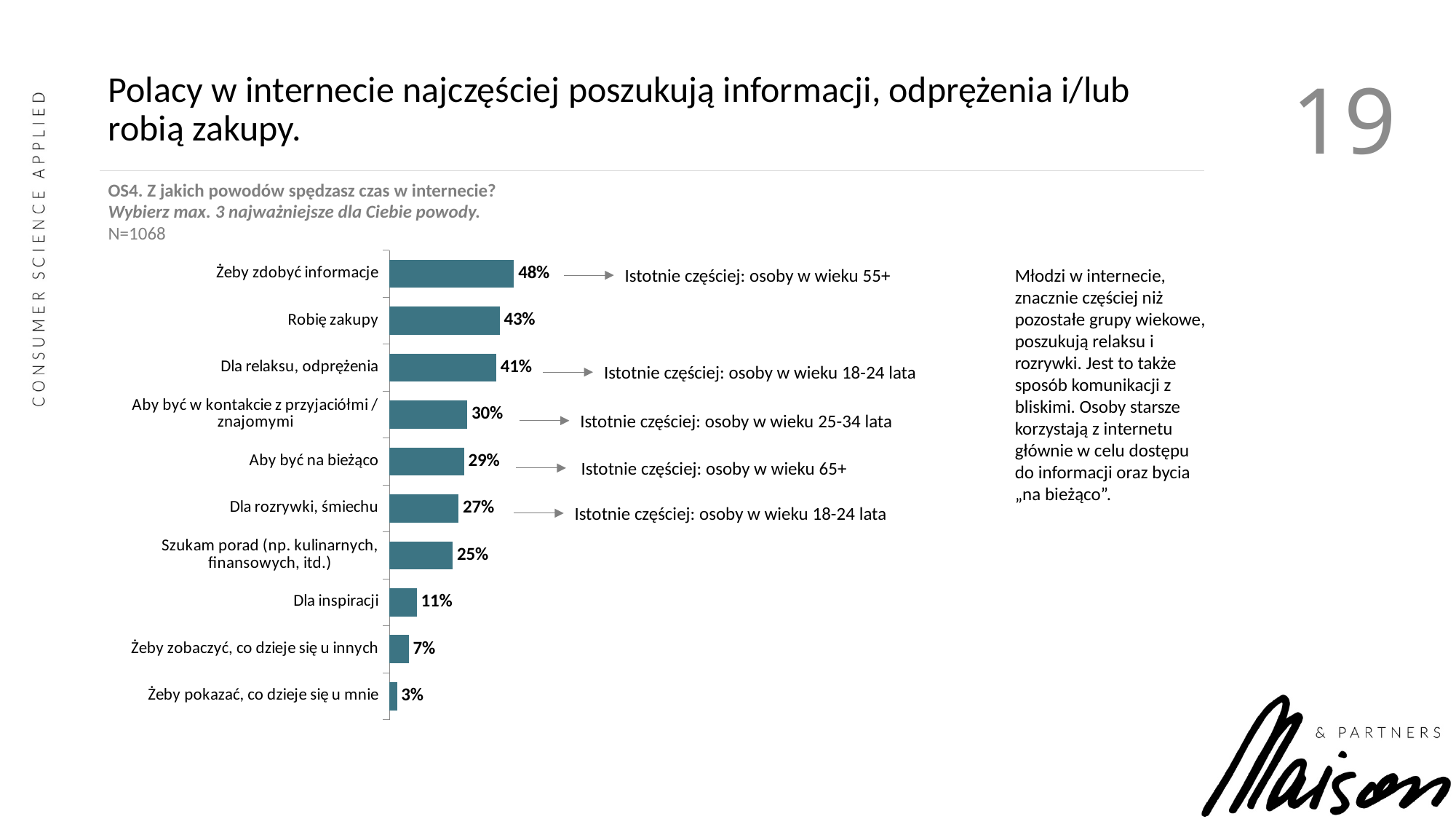
Which category has the highest value? Żeby zdobyć informacje Which is larger: "Aby być na bieżąco" or "Dla rozrywki, śmiechu"? Aby być na bieżąco Which category has the lowest value? Żeby pokazać, co dzieje się u mnie What is the sample size (N) stated above the chart? N=1068 How many categories are shown in the chart? 10 What is the difference between "Żeby zobaczyć, co dzieje się u innych" and "Żeby pokazać, co dzieje się u mnie"? 4 percentage points What kind of chart is shown on the slide? Bar chart What percentage is shown for "Szukam porad (np. kulinarnych, finansowych, itd.)"? 25% What percentage of respondents chose "Żeby zdobyć informacje"? 48% Which age group is noted as significantly more often choosing "Aby być na bieżąco"? osoby w wieku 65+ What is the value for "Dla relaksu, odprężenia"? 41% What is the difference between "Robię zakupy" and "Dla inspiracji"? 32 percentage points